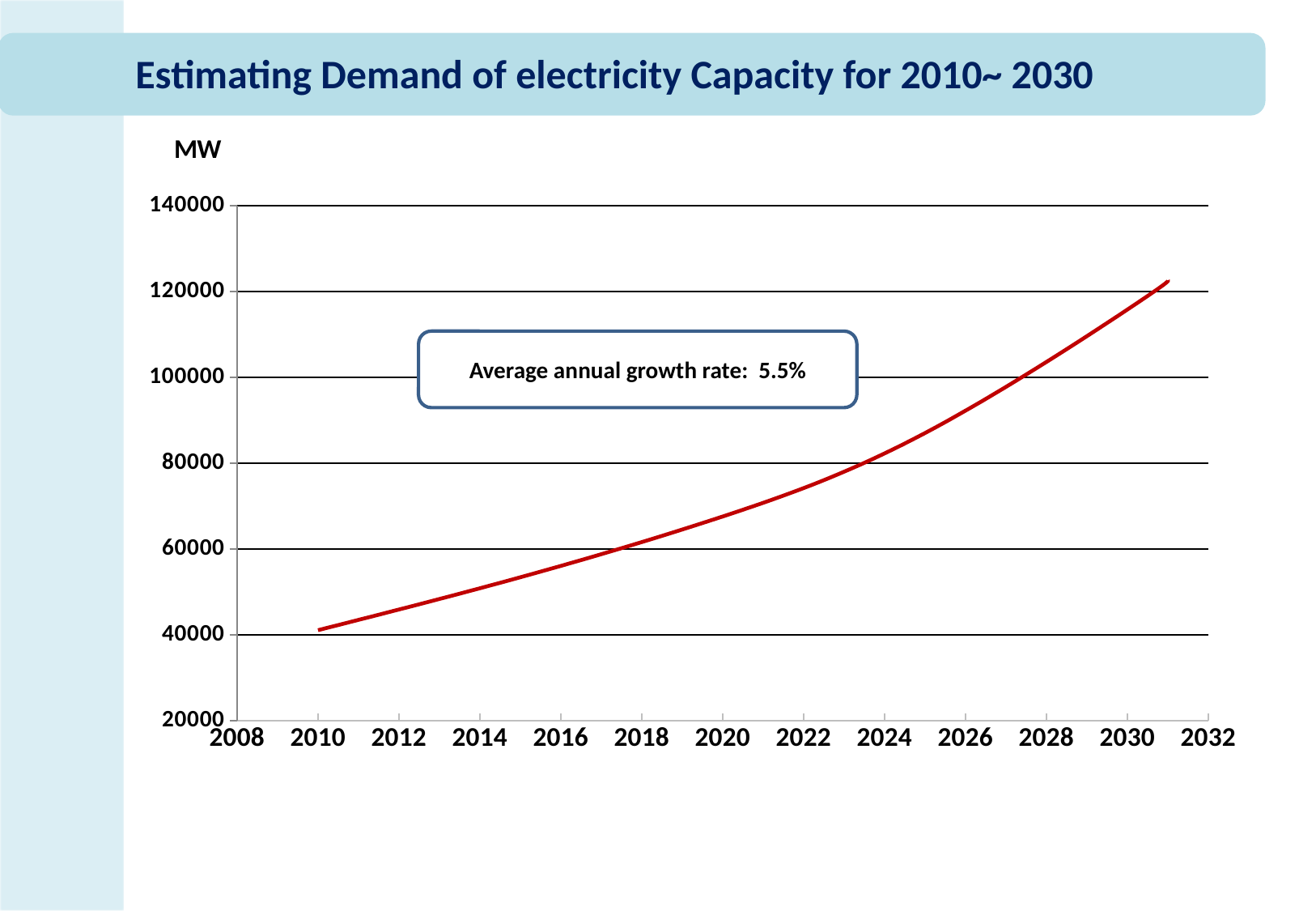
Is the value for 2014 greater or less than 60000? less Is the value for 2026 greater or less than 80000? greater Is the value for 2016 greater or less than 60000? less What average annual growth rate is stated in the box on the chart? 5.5% What unit is shown on the vertical axis of the chart? MW What kind of chart is shown on the slide? line chart Which is larger, the value for 2010 or the value for 2030? 2030 Does the plotted demand rise or fall from 2010 to 2030? rise